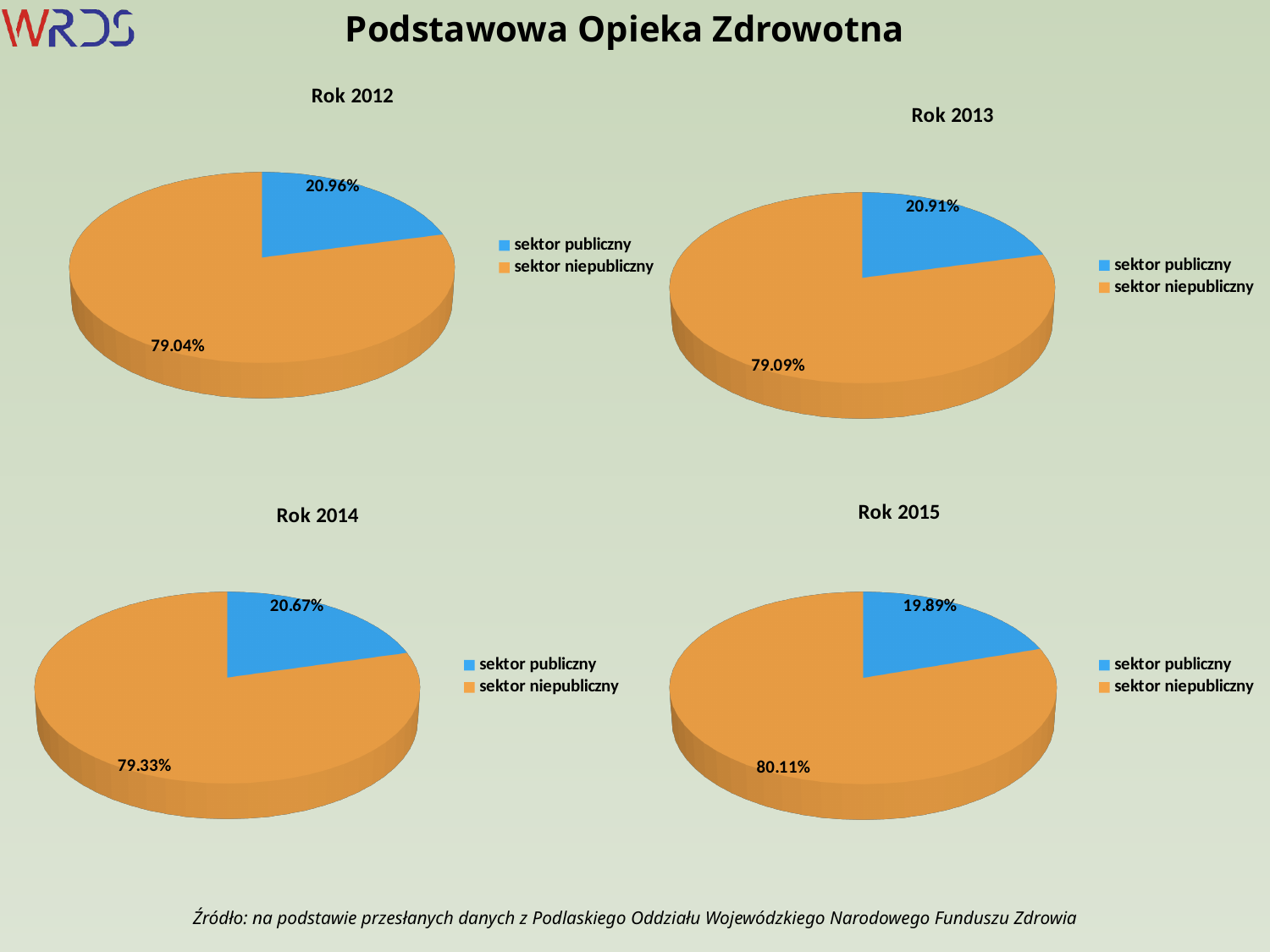
In the 'Rok 2012' chart, which slice is the smallest? sektor publiczny In the 'Rok 2014' chart, what share does 'sektor publiczny' have? 20.67% What kind of chart is the 'Rok 2012' chart? pie chart How many slices does the 'Rok 2013' chart have? 2 In the 'Rok 2013' chart, which is larger: 'sektor publiczny' or 'sektor niepubliczny'? sektor niepubliczny How many entries does the legend of the 'Rok 2015' chart list? 2 In the 'Rok 2014' chart, what colour is the 'sektor publiczny' slice? blue In the 'Rok 2012' chart, what share does 'sektor publiczny' have? 20.96% In the 'Rok 2015' chart, which slice is the largest? sektor niepubliczny In the 'Rok 2013' chart, what share does 'sektor niepubliczny' have? 79.09% In the 'Rok 2015' chart, what share does 'sektor niepubliczny' have? 80.11% In the 'Rok 2014' chart, what is the difference between the 'sektor niepubliczny' and 'sektor publiczny' shares? 58.66%